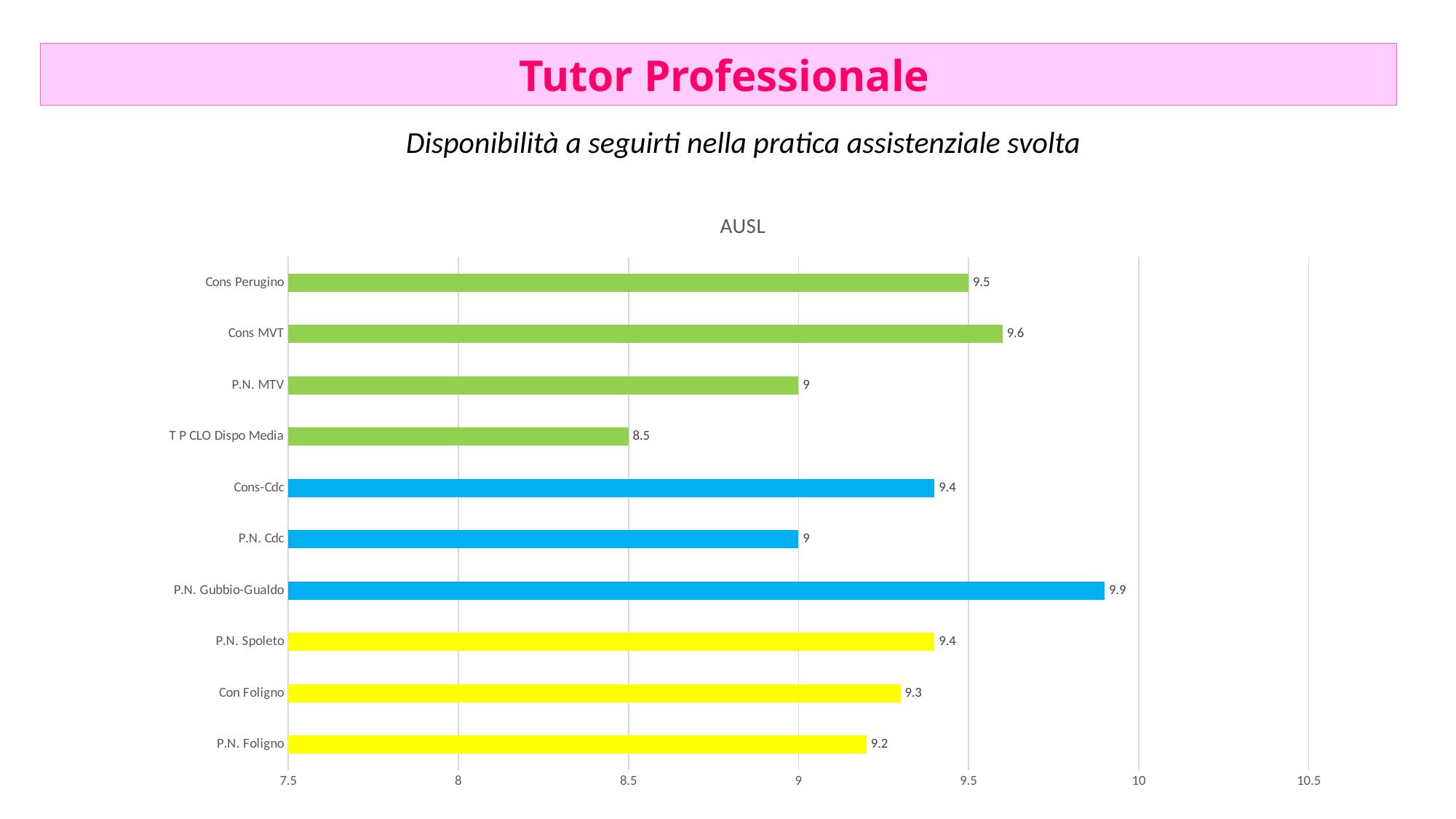
What is the value for T P CLO Dispo Media? 8.5 What is the title of the chart? AUSL What is the value for Con Foligno? 9.3 What is the difference between the values for P.N. Gubbio-Gualdo and T P CLO Dispo Media? 1.4 What is the value for Cons MVT? 9.6 What kind of chart is shown on the slide? Bar chart What is the value for P.N. Gubbio-Gualdo? 9.9 Which is larger, the value for Cons-Cdc or the value for P.N. Cdc? Cons-Cdc How many categories are shown on the chart? 10 Which category has the highest value? P.N. Gubbio-Gualdo What is the difference between the values for Cons MVT and Cons Perugino? 0.1 Which category has the lowest value? T P CLO Dispo Media